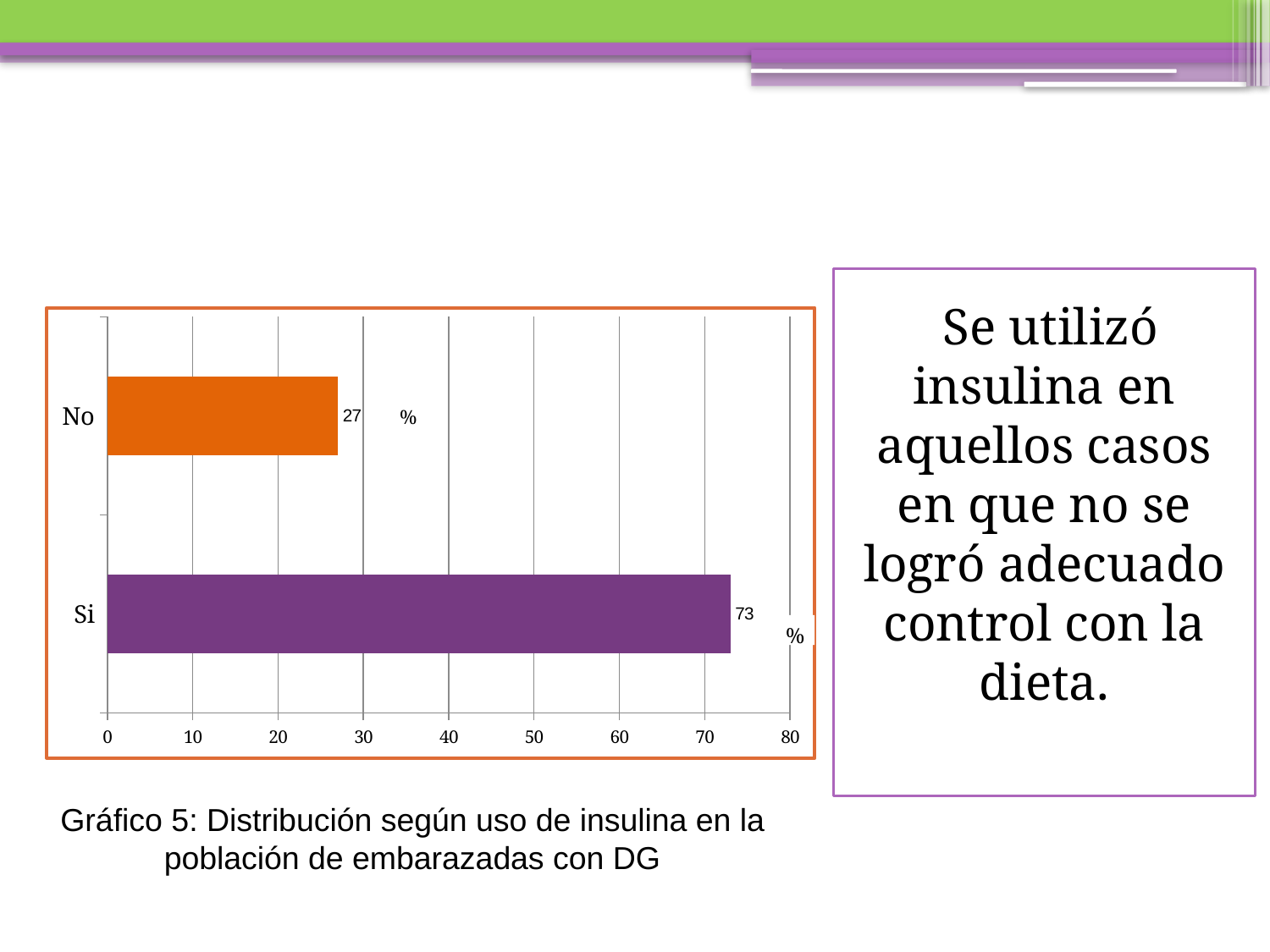
Is the value for "No" greater or less than 30? less What is the maximum value shown on the horizontal axis? 80 What kind of chart is shown on the slide? bar chart What colour is the bar for "No"? orange What is the difference between the values for "Si" and "No"? 46 Which is larger, the value for "Si" or the value for "No"? Si Which category has the highest value? Si How many categories are shown in the chart? 2 What is the value for "No"? 27 Which category has the lowest value? No Is the value for "Si" greater or less than 70? greater What is the value for "Si"? 73